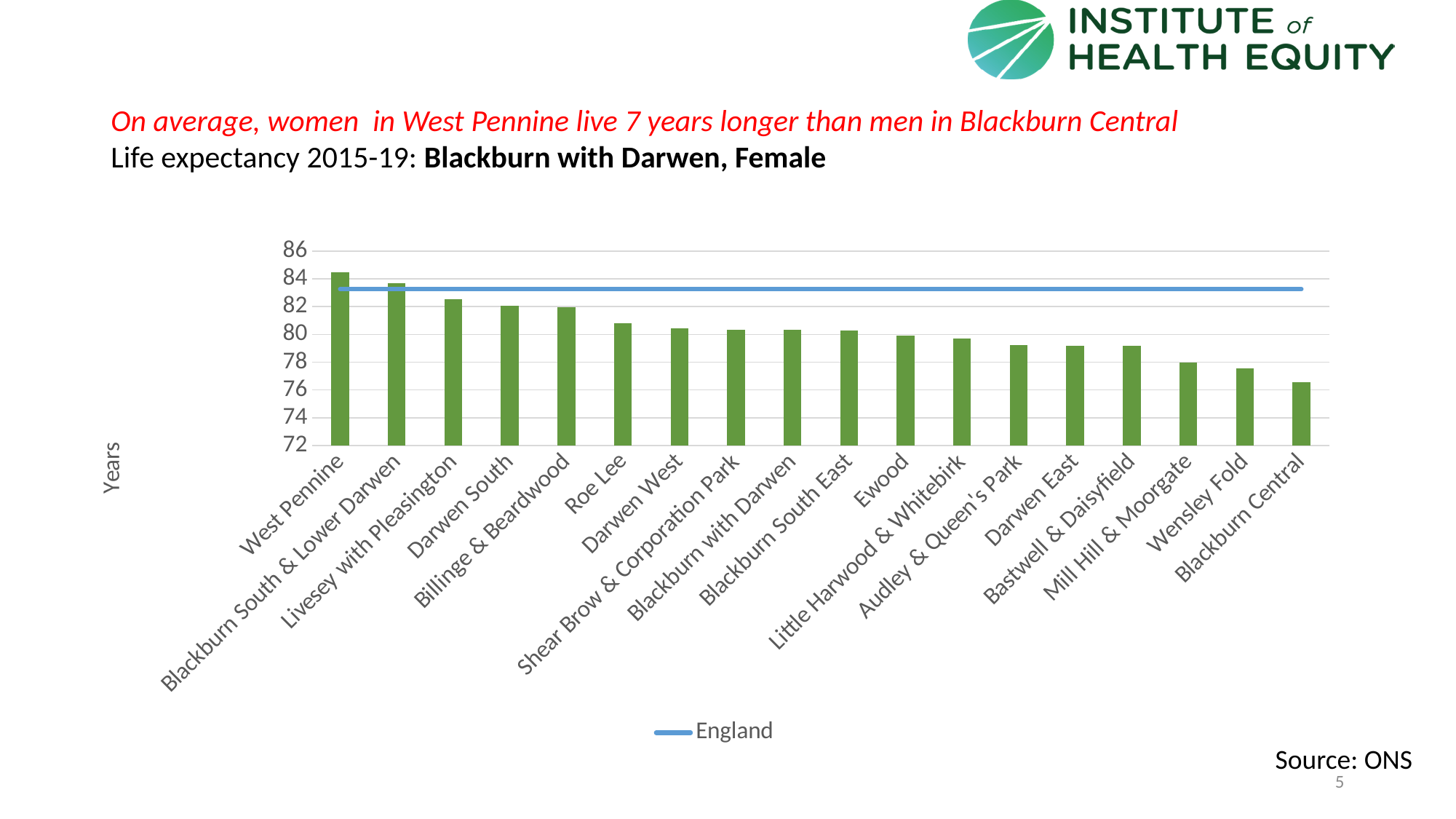
Which area has the lowest female life expectancy in the chart? Blackburn Central Which is larger, the value for Roe Lee or the value for Wensley Fold? Roe Lee Is the value for Roe Lee greater or less than 80? greater Is the value for Blackburn Central greater or less than 78? less Is the value for West Pennine greater or less than 84? greater Which area has the highest female life expectancy in the chart? West Pennine How many areas (bars) are plotted in the chart? 18 Do the bar values rise or fall from left to right along the x axis? fall What kind of chart is shown on the slide? combination bar and line chart How many series does the legend list? 1 What is the label on the vertical axis of the chart? Years